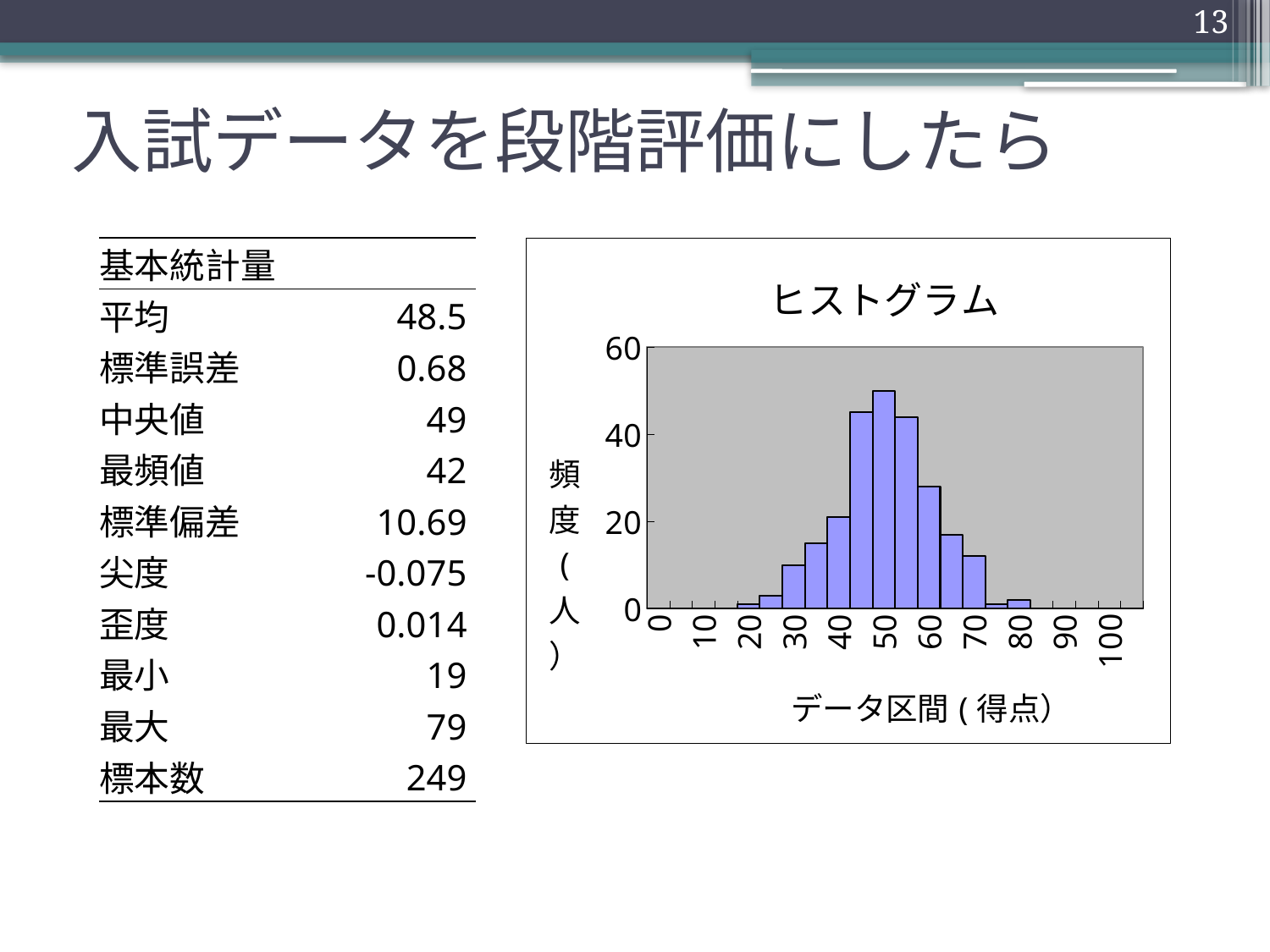
What is the title of the chart? ヒストグラム Is the frequency for the bar at score 40 greater or less than 40? less Do the frequencies rise or fall as the score goes from 50 to 80? fall What kind of chart is shown on the slide? bar chart Is the frequency for the bar at score 30 greater or less than 20? less What is the label of the x axis of the chart? データ区間(得点) Which score interval on the x axis has the highest frequency? 50 Which has the higher frequency, the bar at score 50 or the bar at score 70? 50 Is the frequency for the bar at score 60 greater or less than 20? greater Which has the higher frequency, the bar at score 30 or the bar at score 60? 60